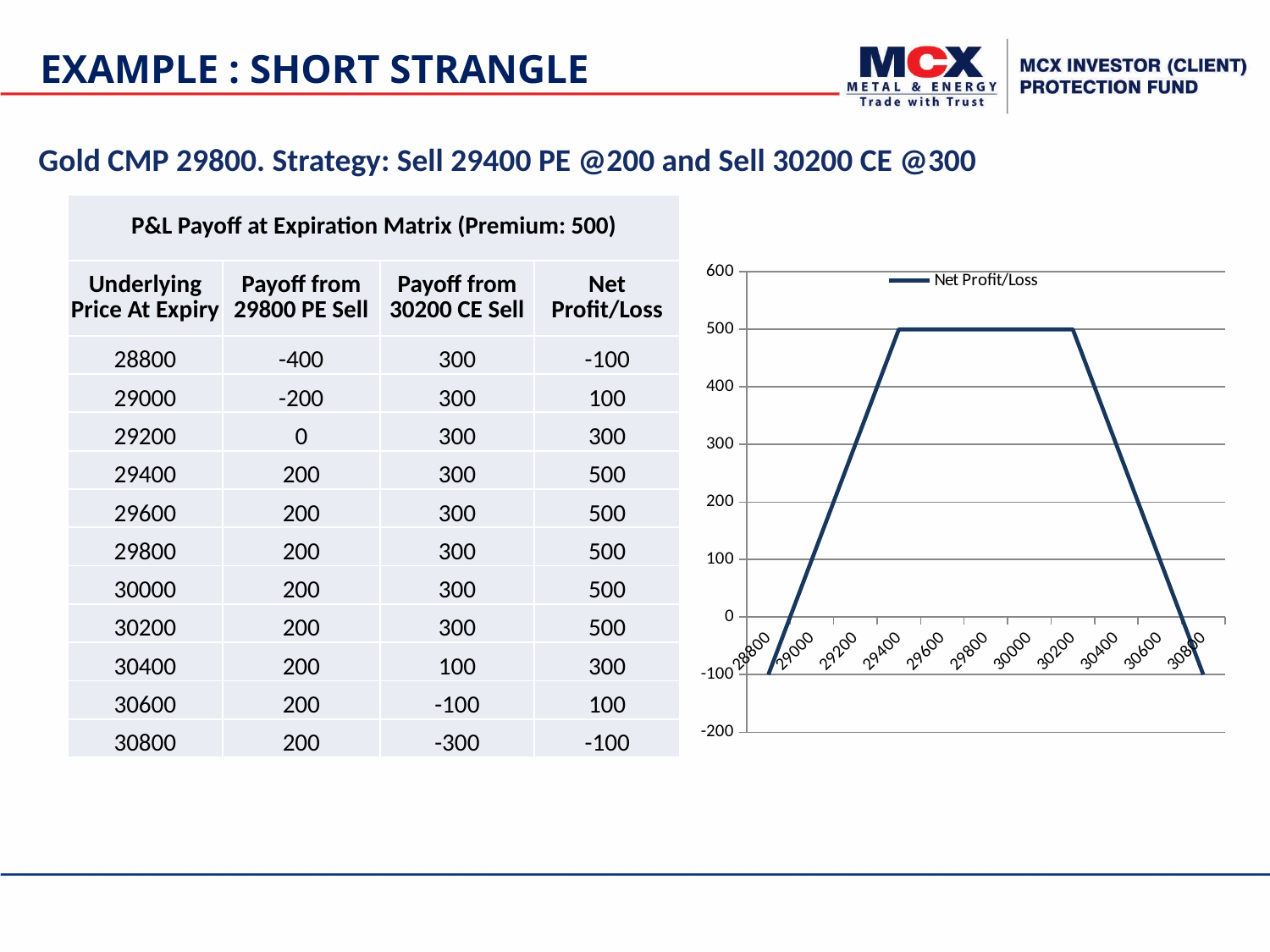
How many series does the chart legend list? 1 What kind of chart is shown on the slide? line chart What is the Net Profit/Loss value at an underlying price of 28800? -100 What is the lowest Net Profit/Loss value shown on the chart? -100 What is the name of the series shown in the chart legend? Net Profit/Loss What is the highest Net Profit/Loss value shown on the chart? 500 What is the difference between the Net Profit/Loss at 29400 and at 30600? 400 Which has a larger Net Profit/Loss, an underlying price of 29000 or 29200? 29200 Does the Net Profit/Loss line rise or fall between 30200 and 30800 on the x axis? fall How many underlying price points are plotted along the x axis of the chart? 11 What is the Net Profit/Loss value at an underlying price of 30400? 300 What is the Net Profit/Loss value at an underlying price of 29800? 500